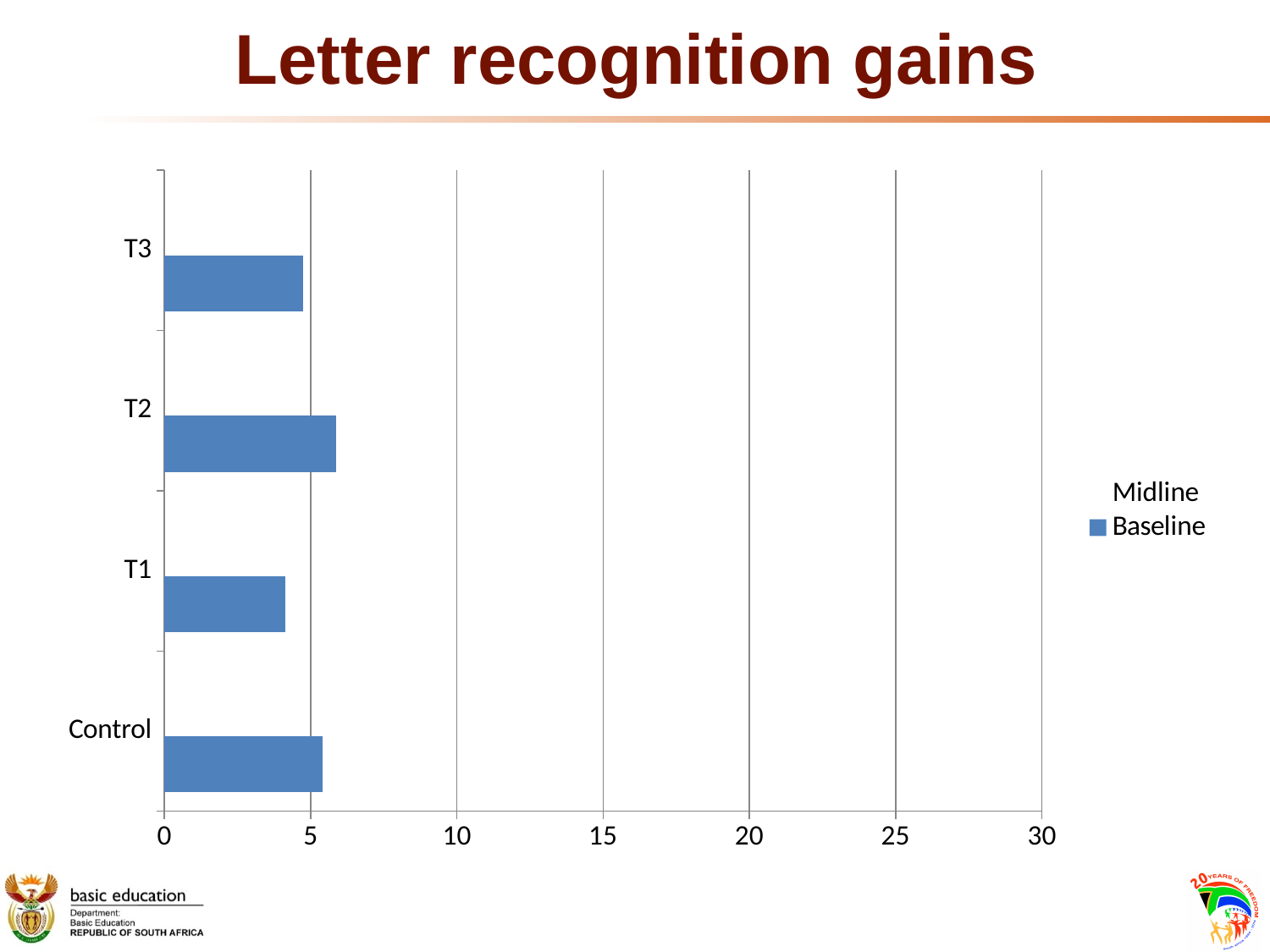
Is the Baseline value for Control greater or less than 10? less How many categories are shown on the chart? 4 Is the Baseline value for T2 greater or less than 5? greater Which has the larger Baseline value, T2 or T1? T2 Which series is shown with blue bars according to the legend? Baseline What kind of chart is shown on the slide? bar chart Which category has the lowest Baseline value? T1 Is the Baseline value for T3 greater or less than 5? less How many series does the legend list? 2 Which category has the highest Baseline value? T2 What is the title of the chart? Letter recognition gains